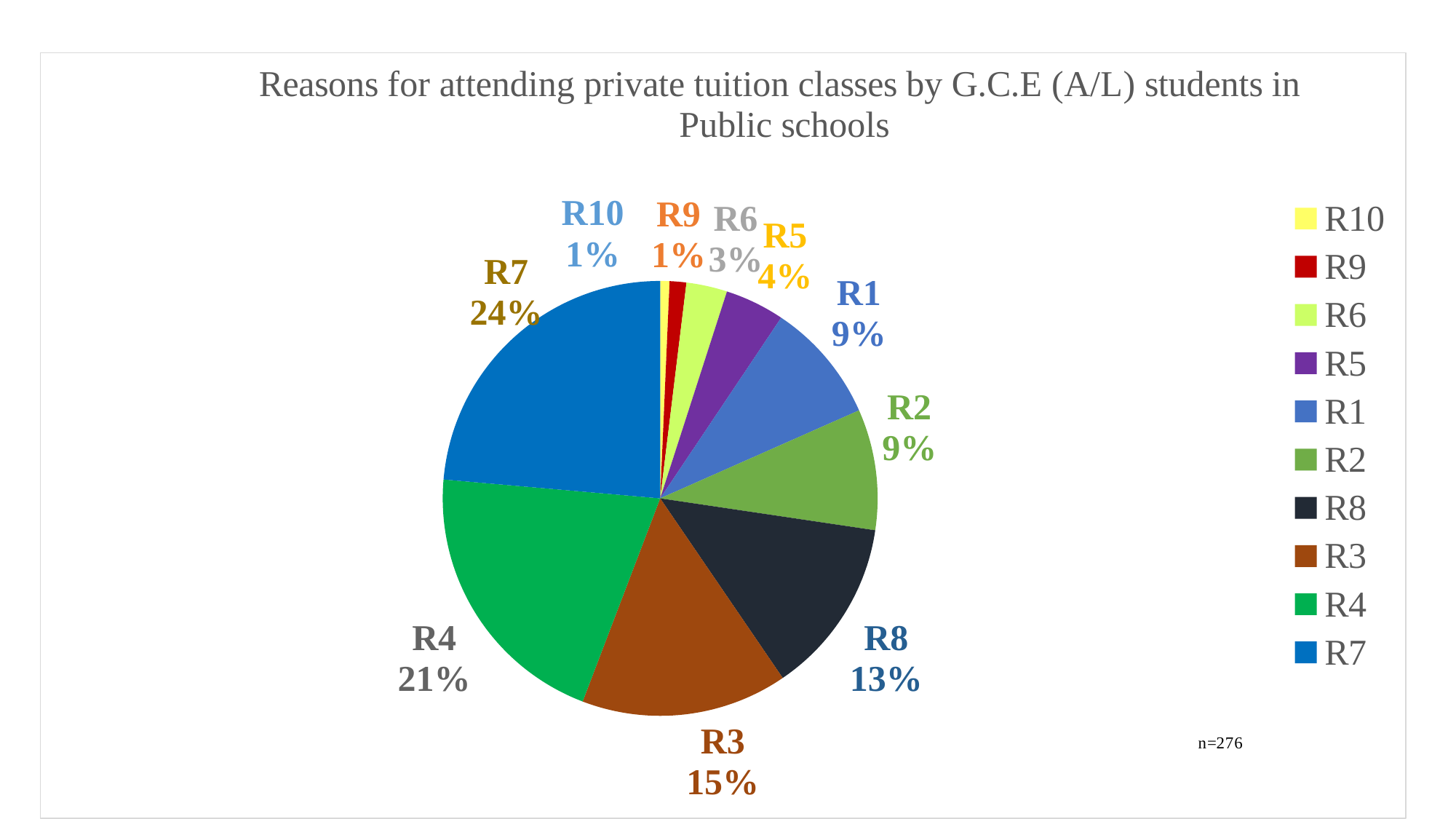
What is the value labelled for R8? 13% Which is larger, the share for R4 or the share for R3? R4 What is the difference in percentage points between R3 and R8? 2 How many reasons (slices) are shown in the pie chart? 10 What type of chart is shown on the slide? Pie chart Which reason has the largest slice of the pie? R7 What is the difference in percentage points between R7 and R4? 3 What share of the pie does R7 represent? 24% Which reason has the smallest share, R5 or R6? R6 What sample size (n) is noted on the slide? n=276 What is the title of the chart? Reasons for attending private tuition classes by G.C.E (A/L) students in Public schools What percentage is shown for R3? 15%